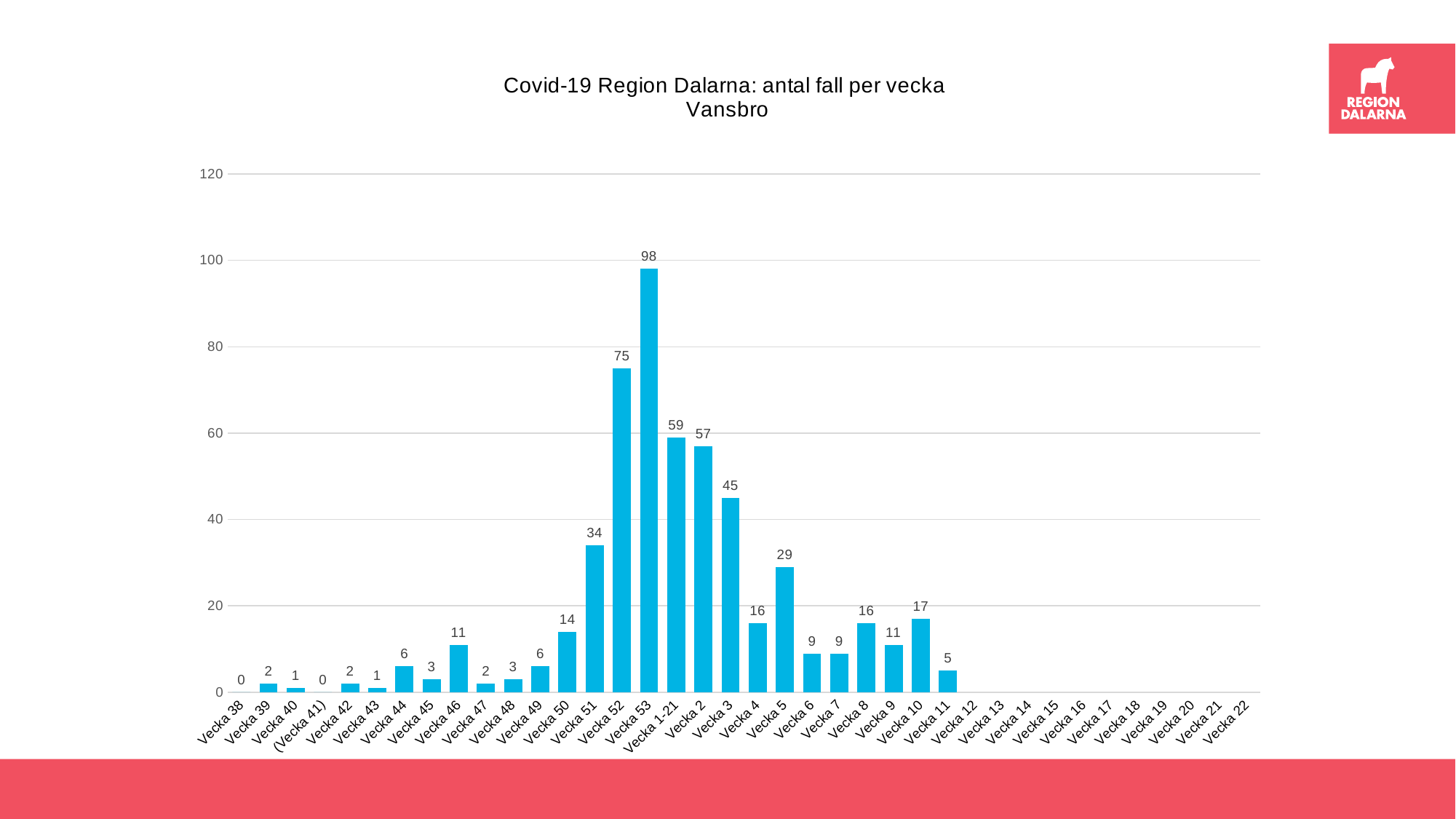
What is the value for Vecka 53? 98 What is the value for Vecka 11? 5 Do the values rise or fall from Vecka 53 to Vecka 4? fall What kind of chart is shown on the slide? Bar chart What is the difference between the values for Vecka 53 and Vecka 52? 23 What is the value for Vecka 52? 75 What is the value for Vecka 5? 29 What is the title of the chart? Covid-19 Region Dalarna: antal fall per vecka Vansbro What is the difference between the values for Vecka 3 and Vecka 4? 29 Is the value for Vecka 51 greater or less than 40? less Which is larger, the value for Vecka 1-21 or the value for Vecka 2? Vecka 1-21 Which week has the highest number of cases? Vecka 53